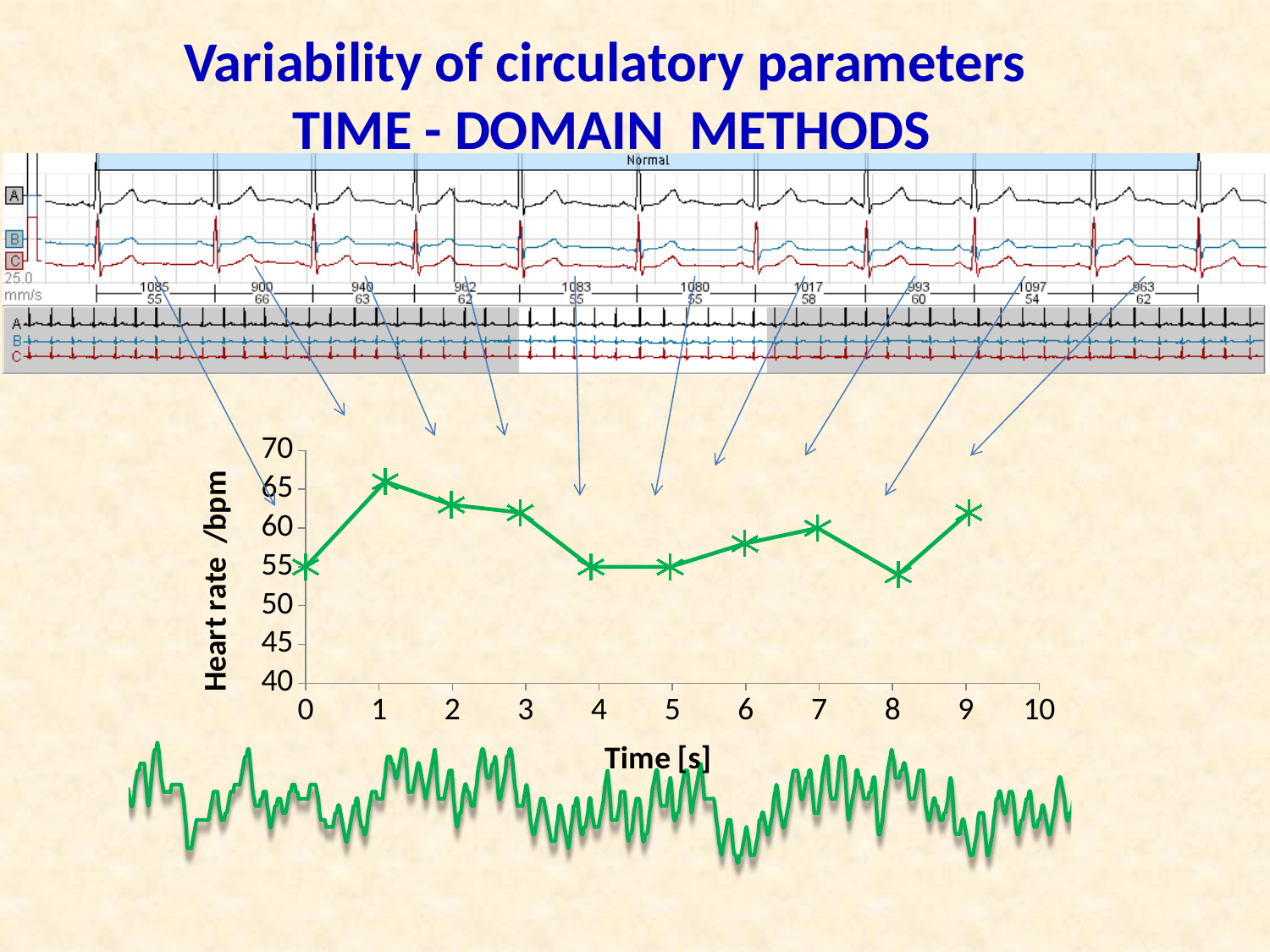
Is the heart rate at time 4 s greater or less than 60 bpm? less Is the heart rate at time 8 s greater or less than 60 bpm? less What is the label of the horizontal axis of the line chart? Time [s] At which time (in seconds) does the heart rate reach its highest value on the line chart? 1 Which is higher on the line chart: the heart rate at time 9 s or at time 8 s? time 9 s Between time 1 s and time 4 s, does the heart rate on the line chart rise or fall? fall What kind of chart is shown on the slide? line chart What is the label of the vertical axis of the line chart? Heart rate /bpm Is the heart rate at time 1 s greater or less than 60 bpm? greater How many data points are plotted on the heart rate line chart? 10 Which is higher on the line chart: the heart rate at time 1 s or at time 4 s? time 1 s